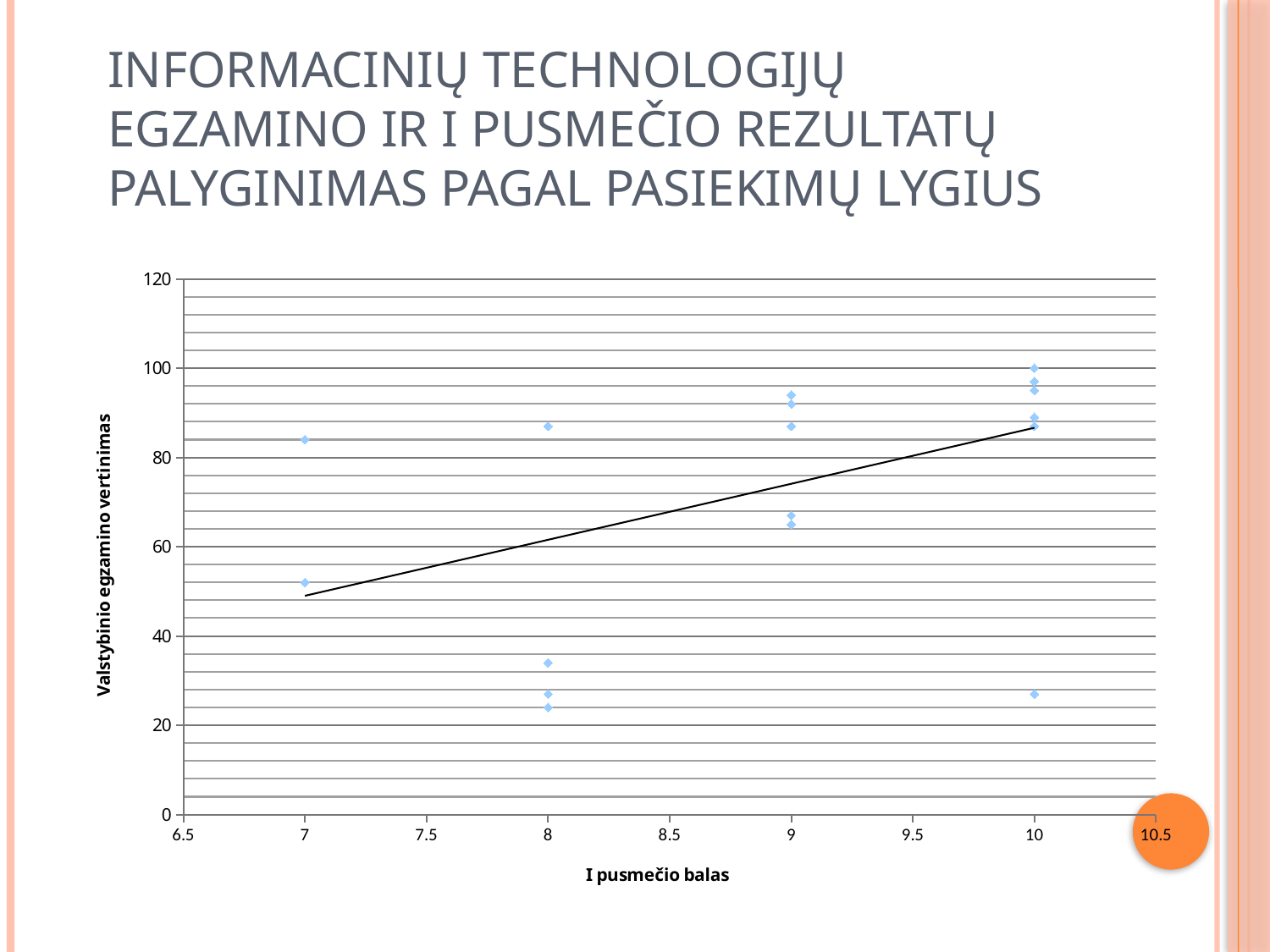
Is the highest point at I pusmečio balas 8 greater or less than 80? greater Is the lowest point at I pusmečio balas 10 greater or less than 40? less Is the lowest point at I pusmečio balas 7 greater or less than 40? greater What is the title of the vertical axis of the chart? Valstybinio egzamino vertinimas How many data points are plotted at I pusmečio balas 8? 4 What kind of chart is shown on the slide? Scatter chart How many data points are plotted at I pusmečio balas 7? 2 Does the trend line on the chart rise or fall as the I pusmečio balas increases? Rises What is the title of the horizontal axis of the chart? I pusmečio balas At which I pusmečio balas value does the highest Valstybinio egzamino vertinimas point appear? 10 What is the maximum value shown on the vertical axis? 120